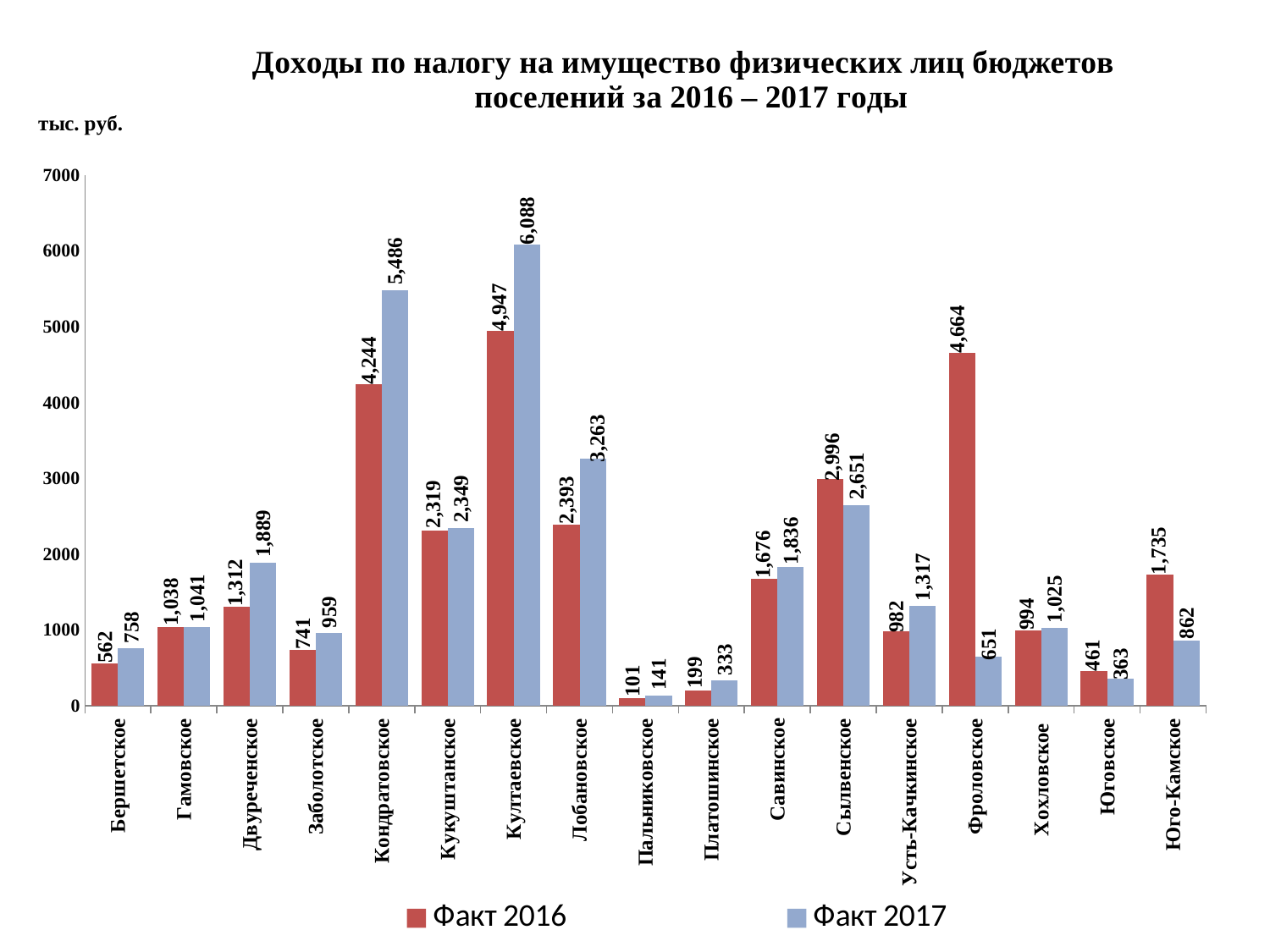
How many series does the legend list? 2 What is the difference between the Факт 2017 and Факт 2016 values for Култаевское? 1,141 What is the Факт 2017 value for Кондратовское? 5,486 Which settlement has the lowest Факт 2016 value? Пальниковское What is the difference between the Факт 2016 and Факт 2017 values for Фроловское? 4,013 What type of chart is shown on the slide? Bar chart What unit of measurement is indicated above the vertical axis? тыс. руб. Which settlement has the highest Факт 2017 value? Култаевское What is the Факт 2016 value for Фроловское? 4,664 How many settlements are shown on the x axis? 17 For Сылвенское, which is larger: the Факт 2016 value or the Факт 2017 value? Факт 2016 What is the Факт 2016 value for Лобановское? 2,393